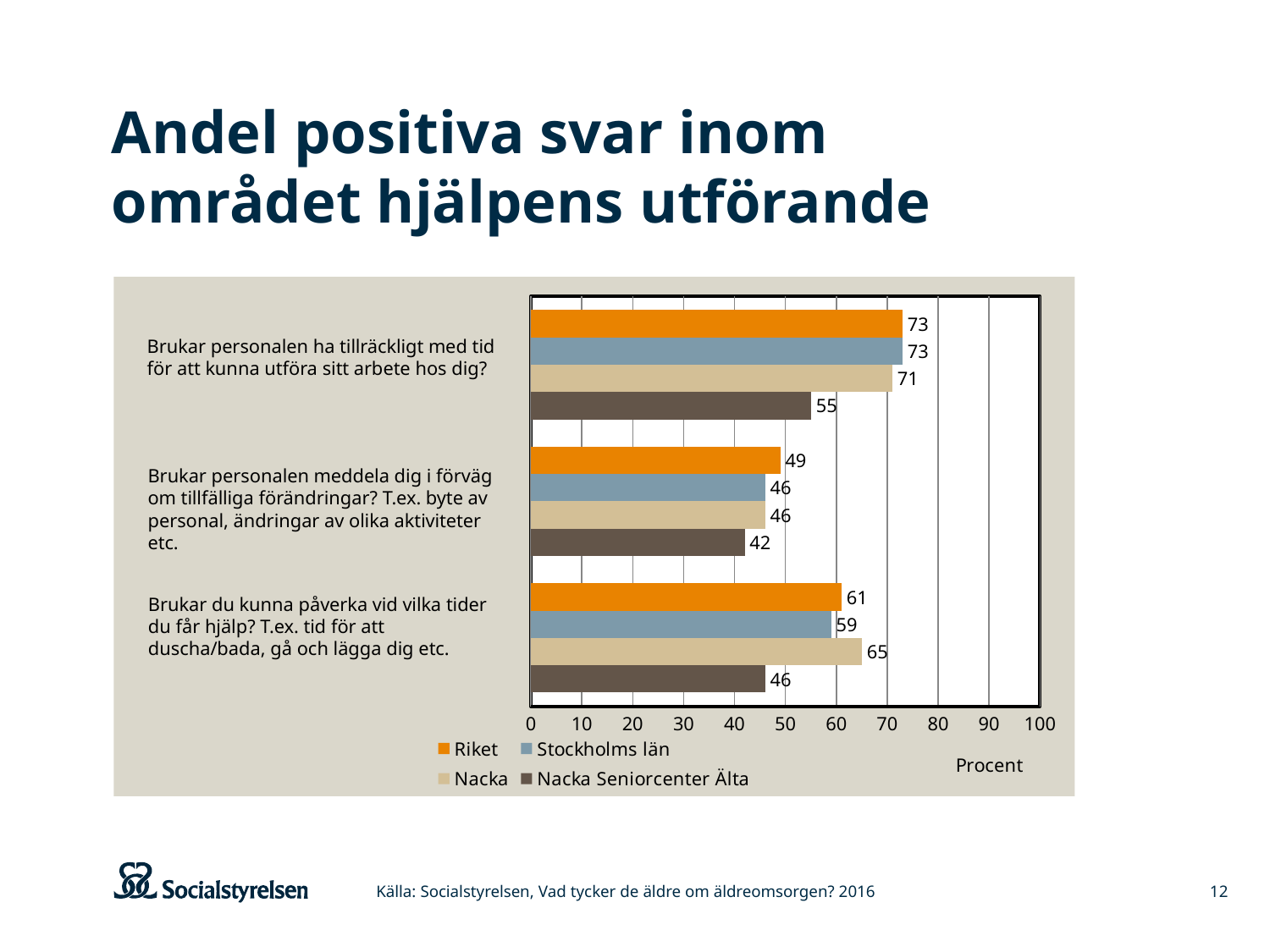
How many questions (categories) are shown on the chart? 3 What is the difference between Nacka and Nacka Seniorcenter Älta on the question "Brukar personalen ha tillräckligt med tid för att kunna utföra sitt arbete hos dig?"? 16 What is the value for Nacka on the question "Brukar personalen meddela dig i förväg om tillfälliga förändringar?"? 46 Which series has the highest value on the question "Brukar du kunna påverka vid vilka tider du får hjälp?"? Nacka What kind of chart is shown on the slide? Bar chart What is the value for Riket on the question "Brukar personalen ha tillräckligt med tid för att kunna utföra sitt arbete hos dig?"? 73 What unit is shown on the horizontal axis of the chart? Procent Is the value for Riket on the question "Brukar personalen meddela dig i förväg om tillfälliga förändringar?" greater or less than 50? less Which series has the lowest value on the question "Brukar personalen ha tillräckligt med tid för att kunna utföra sitt arbete hos dig?"? Nacka Seniorcenter Älta What is the value for Nacka Seniorcenter Älta on the question "Brukar du kunna påverka vid vilka tider du får hjälp?"? 46 How many series does the legend list? 4 Which is larger on the question "Brukar du kunna påverka vid vilka tider du får hjälp?": Riket or Stockholms län? Riket